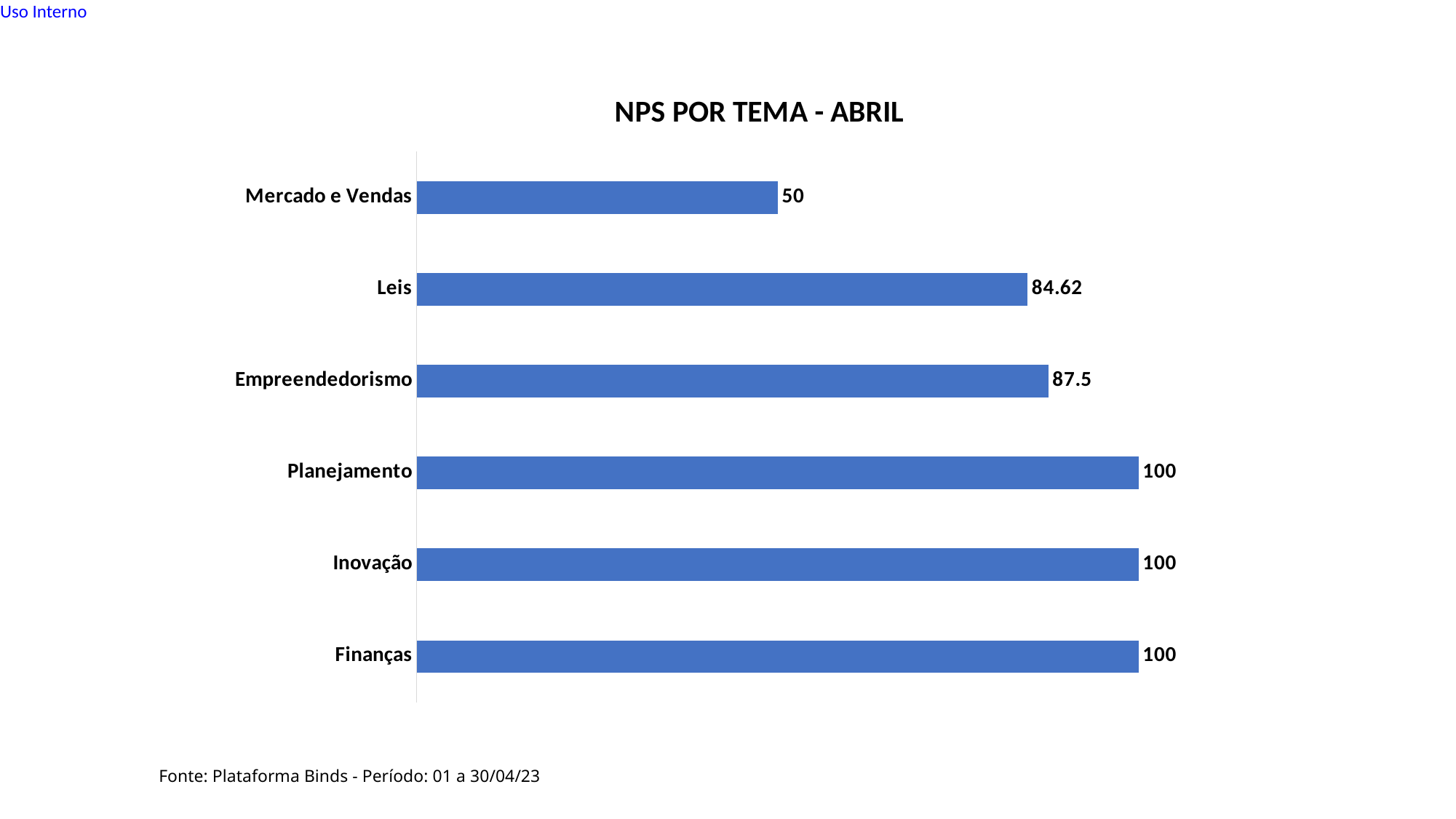
What kind of chart is shown on the slide? Bar chart What is the NPS value for Empreendedorismo? 87.5 What is the NPS value for Mercado e Vendas? 50 What is the title of the chart? NPS POR TEMA - ABRIL How many categories have an NPS value of 100? 3 How many categories are shown in the chart? 6 Which category has the lowest NPS value? Mercado e Vendas Which has a higher NPS value, Leis or Empreendedorismo? Empreendedorismo What is the difference between the NPS values for Finanças and Mercado e Vendas? 50 What is the NPS value for Planejamento? 100 What is the NPS value for Leis? 84.62 What is the difference between the NPS values for Empreendedorismo and Leis? 2.88